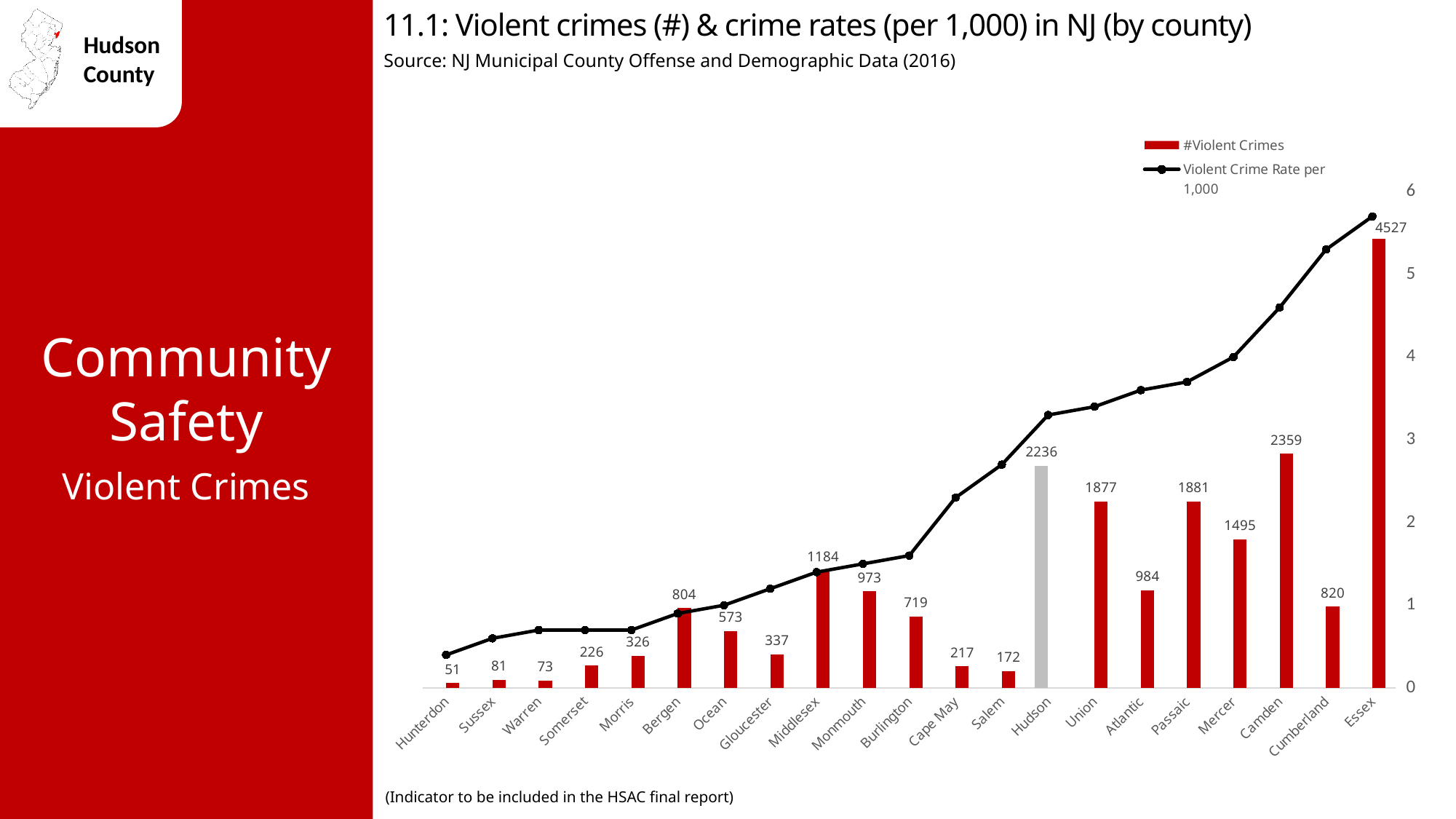
Is the violent crime rate per 1,000 for Hunterdon greater or less than 1? less How many counties are shown on the x axis? 21 What is the difference in the number of violent crimes between Essex and Hudson? 2291 Which county has the lowest number of violent crimes? Hunterdon Does the violent crime rate per 1,000 line generally rise or fall from Hunterdon to Essex? Rise What is the number of violent crimes for Middlesex? 1184 What kind of chart is this? Combined bar and line chart What is the number of violent crimes for Hudson County? 2236 Is the violent crime rate per 1,000 for Essex greater or less than 5? greater Which county has the highest number of violent crimes? Essex How many series does the legend list? 2 Which county has more violent crimes, Camden or Union? Camden